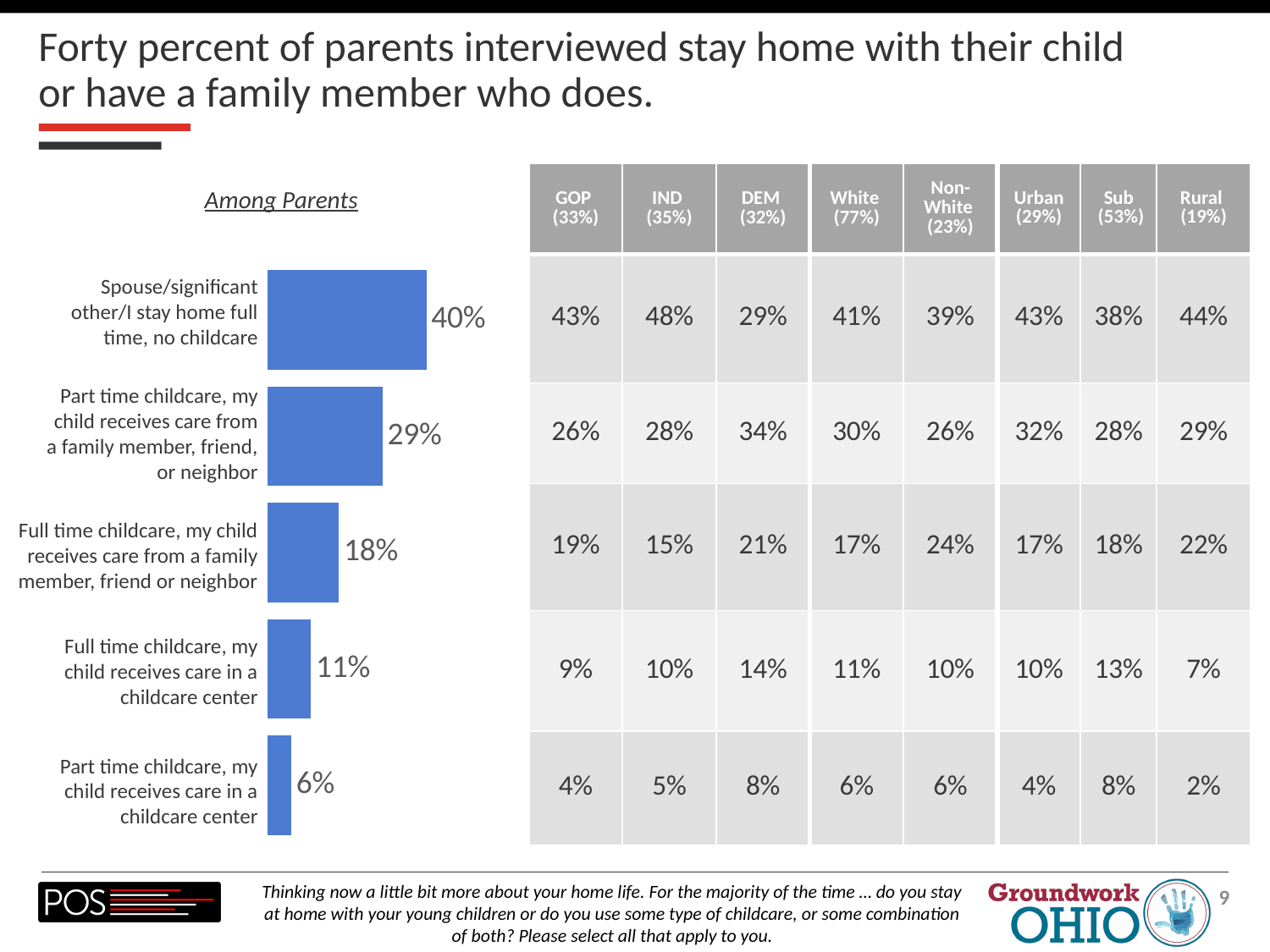
How many categories does the bar chart show? 5 What is the value for "Spouse/significant other/I stay home full time, no childcare" in the bar chart? 40% What is the value for "Part time childcare, my child receives care in a childcare center" in the bar chart? 6% What is the value for "Part time childcare, my child receives care from a family member, friend, or neighbor" in the bar chart? 29% What is the value for "Full time childcare, my child receives care in a childcare center" in the bar chart? 11% What is the difference between the values for "Full time childcare, my child receives care in a childcare center" and "Part time childcare, my child receives care in a childcare center"? 5% What is the difference between the values for "Spouse/significant other/I stay home full time, no childcare" and "Part time childcare, my child receives care from a family member, friend, or neighbor"? 11% Which category has the lowest value in the bar chart? Part time childcare, my child receives care in a childcare center What is the subtitle shown above the bar chart? Among Parents Which category has the highest value in the bar chart? Spouse/significant other/I stay home full time, no childcare Which is larger in the bar chart: "Full time childcare, my child receives care from a family member, friend or neighbor" or "Full time childcare, my child receives care in a childcare center"? Full time childcare, my child receives care from a family member, friend or neighbor What kind of chart is shown on the slide? bar chart